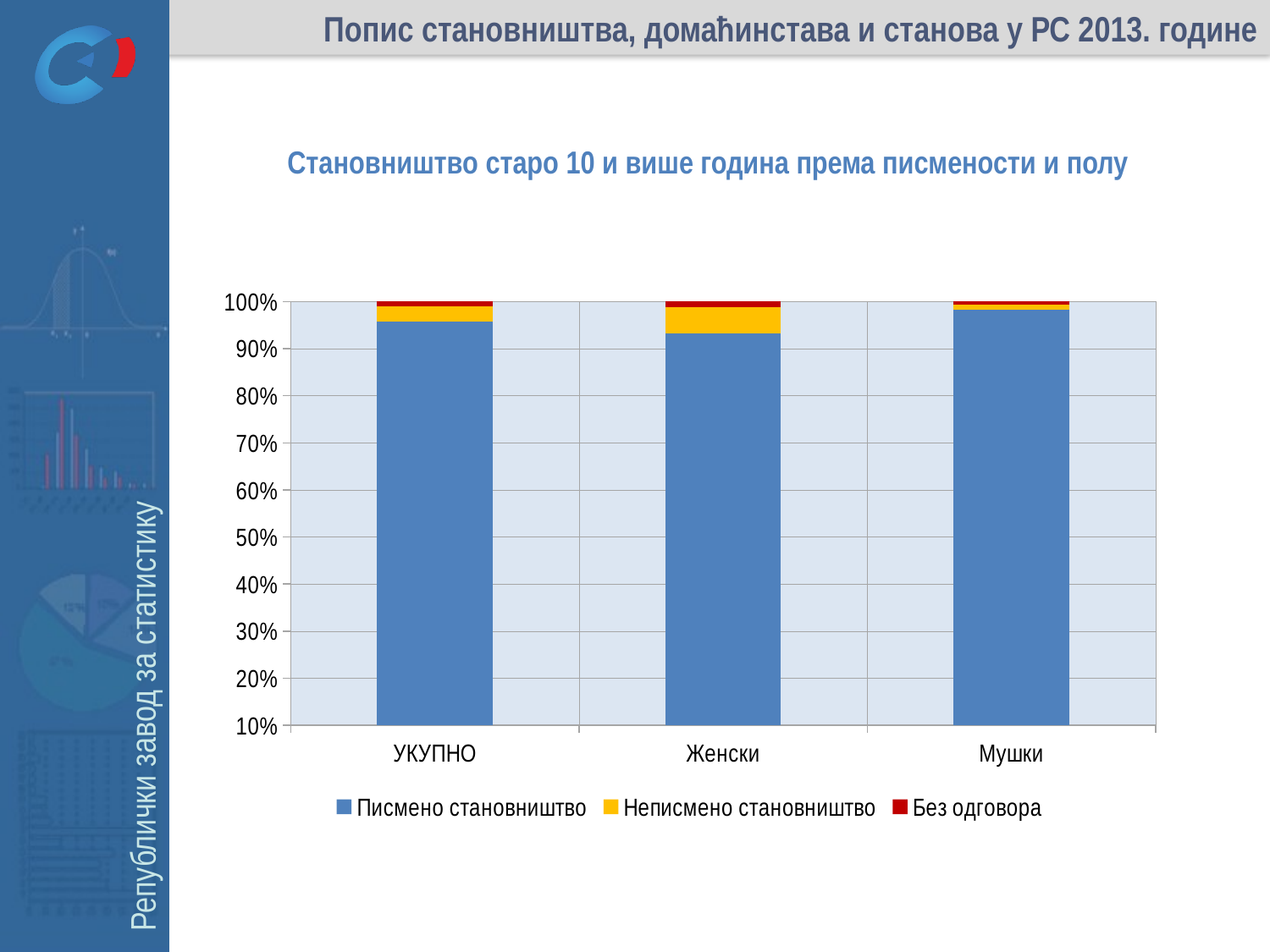
Is the value for Писмено становништво in the УКУПНО category greater or less than 90%? greater What is the total height of the stacked bar for УКУПНО? 100% Which is larger, the Писмено становништво value for Мушки or for Женски? Мушки How many series does the chart legend list? 3 Which category has the highest value for Писмено становништво? Мушки Which category has the lowest value for Писмено становништво? Женски Is the value for Писмено становништво in the Женски category greater or less than 90%? greater Which colour represents the series Неписмено становништво in the chart? yellow What is the title of the chart? Становништво старо 10 и више година према писмености и полу What kind of chart is shown on the slide? stacked bar chart Which category has the largest share of Неписмено становништво? Женски How many categories are shown on the x axis of the chart? 3